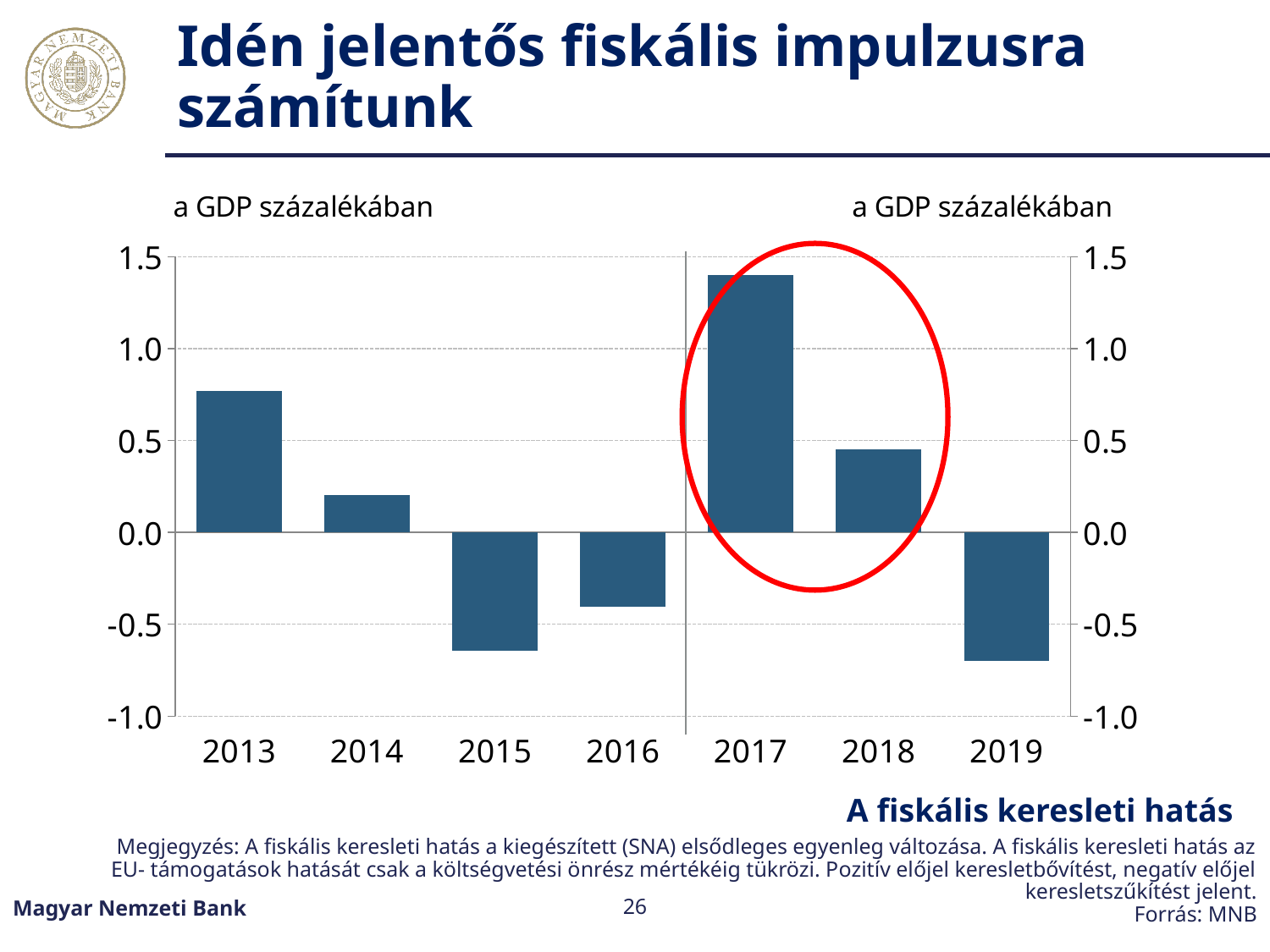
Is the value for 2017 greater or less than 1.0? greater Is the value for 2015 greater or less than -0.5? less What kind of chart is shown on the slide? bar chart Is the value for 2013 greater or less than 0.5? greater What is the title of the chart, shown below it? A fiskális keresleti hatás Which year has the highest value in the chart? 2017 How many years are shown on the x axis of the chart? 7 Do the values rise or fall from 2017 to 2019? fall Which is larger, the value for 2017 or the value for 2018? 2017